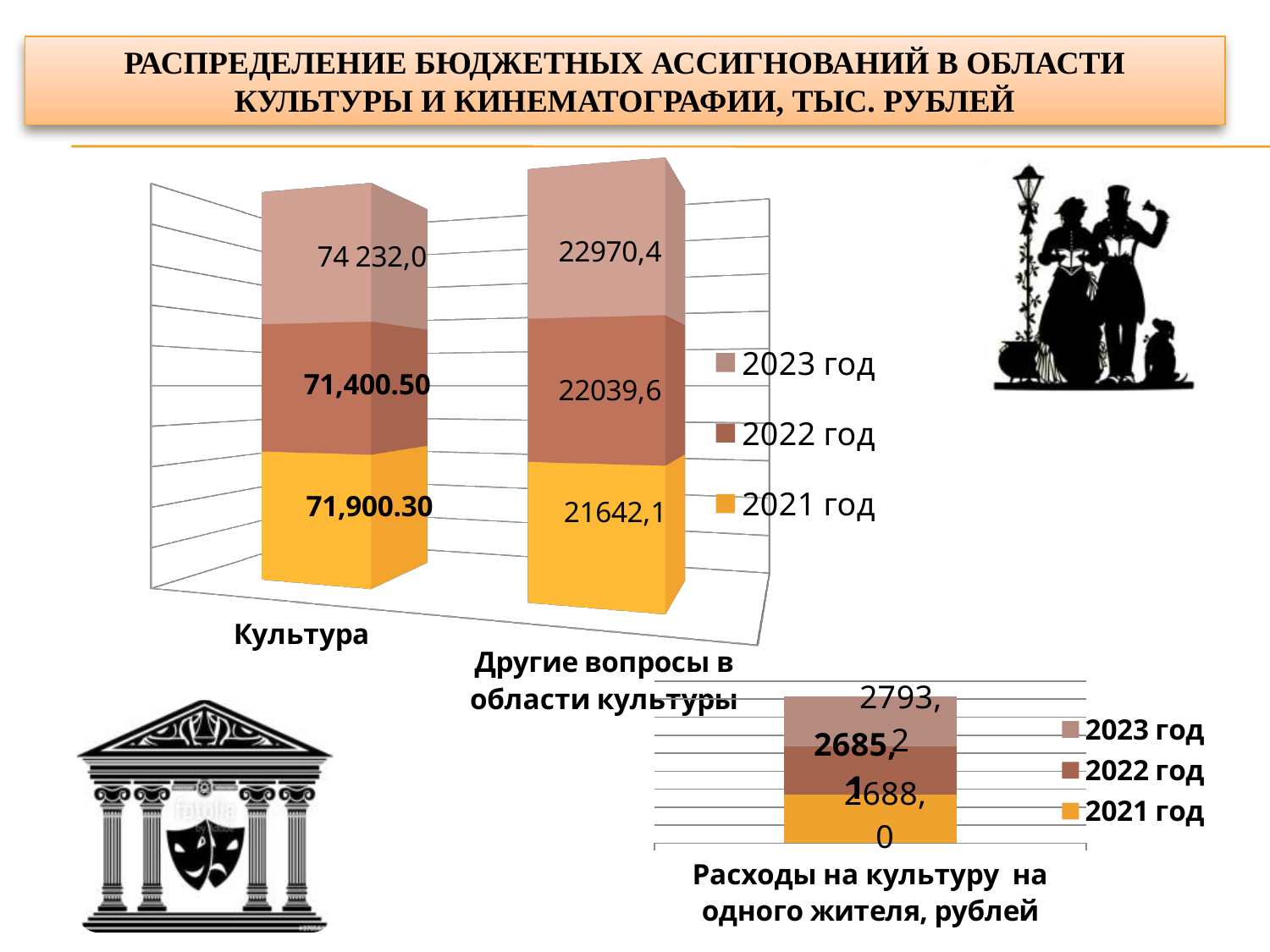
What kind of chart is the chart titled Расходы на культуру на одного жителя, рублей? Stacked bar chart In the top stacked bar chart, what is the total of the stacked bar for Другие вопросы в области культуры? 66652,1 In the top stacked bar chart, which year has the lowest value in the Другие вопросы в области культуры category? 2021 год In the top stacked bar chart, what is the value for 2022 год in the Культура category? 71,400.50 In the top stacked bar chart, what is the value for 2022 год in the Другие вопросы в области культуры category? 22039,6 In the top stacked bar chart, which year has the highest value in the Культура category? 2023 год How many series does the legend of the chart titled Расходы на культуру на одного жителя, рублей list? 3 How many categories are shown on the x axis of the top stacked bar chart? 2 In the top stacked bar chart, what is the difference between the 2023 год and 2022 год values for Другие вопросы в области культуры? 930,8 In the top stacked bar chart, which is larger for Культура: the 2021 год value or the 2022 год value? 2021 год In the top stacked bar chart, what is the value for 2023 год in the Культура category? 74 232,0 In the top stacked bar chart, what is the value for 2021 год in the Другие вопросы в области культуры category? 21642,1